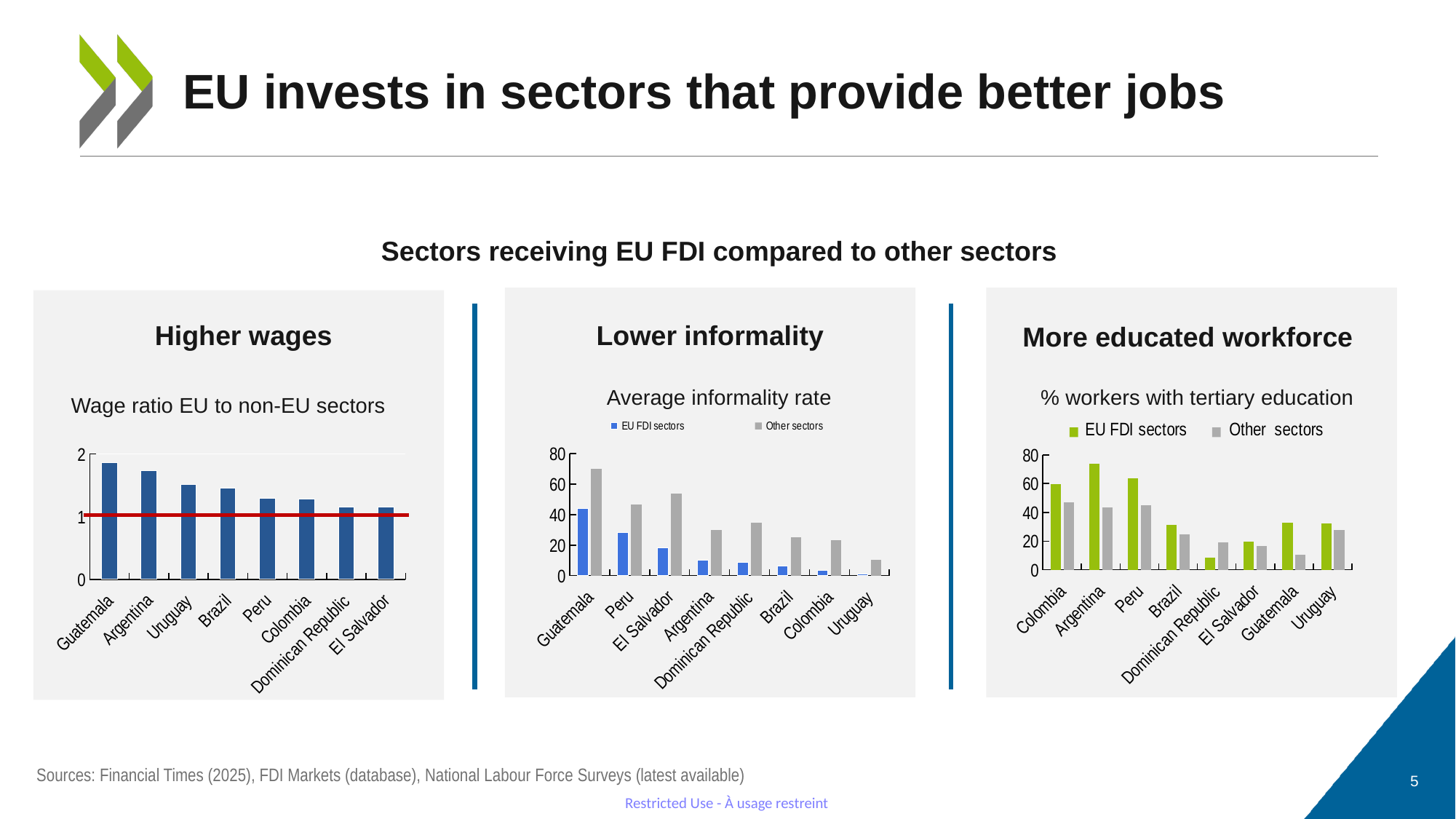
In the 'Average informality rate' chart, how many series does the legend list? 2 In the '% workers with tertiary education' chart, which country has the highest share of workers with tertiary education in EU FDI sectors? Argentina In the '% workers with tertiary education' chart, what colour are the EU FDI sectors bars? green What kind of chart is the 'Wage ratio EU to non-EU sectors' chart? bar chart In the 'Average informality rate' chart, for Guatemala, which is larger: EU FDI sectors or Other sectors? Other sectors In the 'Wage ratio EU to non-EU sectors' chart, do the values rise or fall from left to right? fall In the 'Wage ratio EU to non-EU sectors' chart, how many countries are shown? 8 In the 'Wage ratio EU to non-EU sectors' chart, is the value for Guatemala greater or less than 1? greater In the 'Wage ratio EU to non-EU sectors' chart, which country has the highest wage ratio? Guatemala In the 'Average informality rate' chart, which country has the highest informality rate in EU FDI sectors? Guatemala In the '% workers with tertiary education' chart, which country has the lowest EU FDI sectors value? Dominican Republic In the 'Average informality rate' chart, is the 'Other sectors' value for Guatemala greater or less than 60? greater